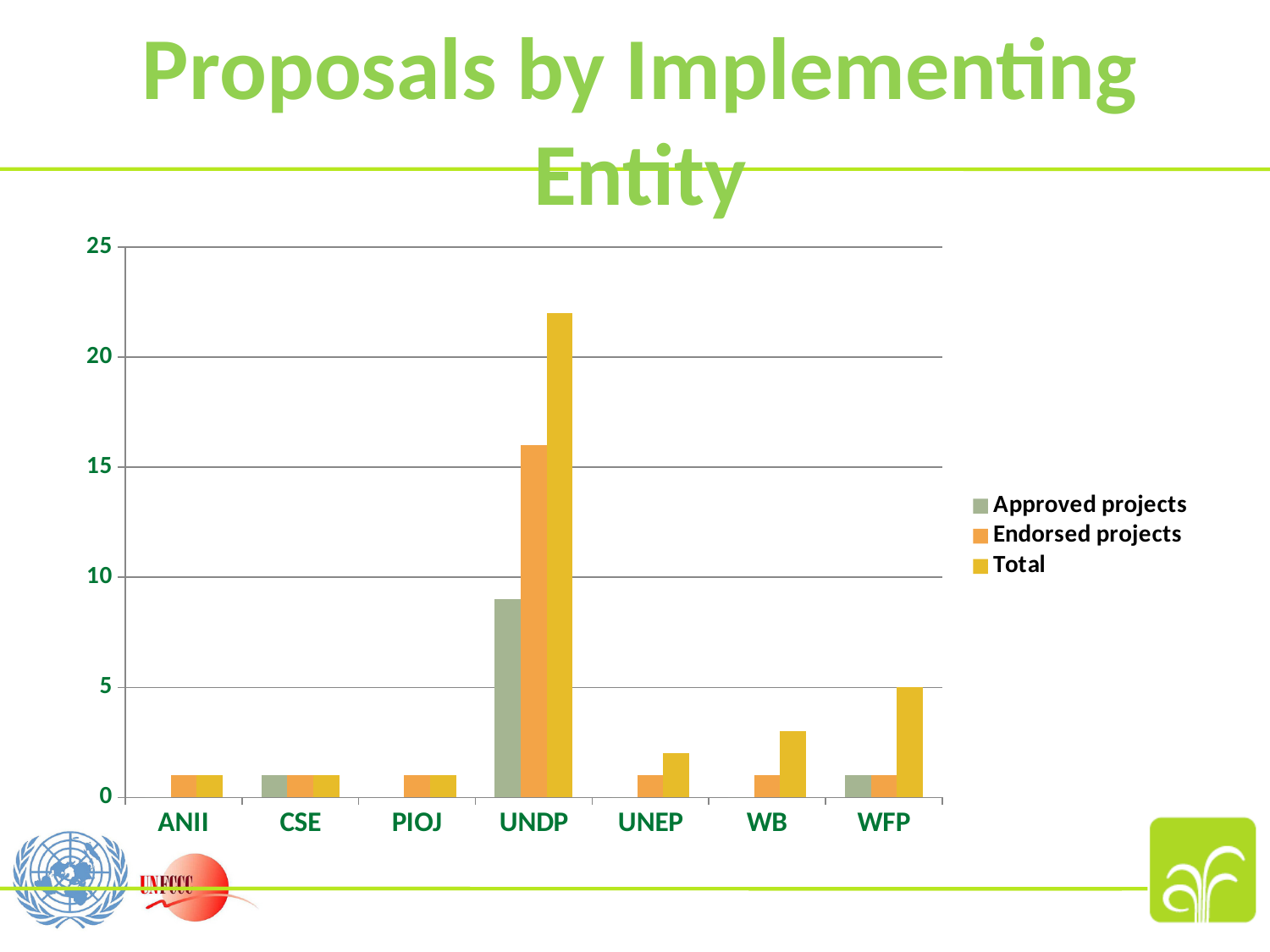
Is the Total for UNDP greater or less than 20? greater Which is larger, the Endorsed projects value for UNDP or the Approved projects value for UNDP? Endorsed projects How many series does the legend list? 3 Which is larger, the Total for WB or the Total for UNEP? WB What type of chart is shown on the slide? bar chart What is the title of the chart? Proposals by Implementing Entity Which implementing entity has the highest Total? UNDP What colour represents the Total series in the legend? yellow How many implementing entities are shown on the x axis? 7 Is the Approved projects value for UNDP greater or less than 10? less What is the Total for WFP? 5 Is the Endorsed projects value for UNDP greater or less than 15? greater